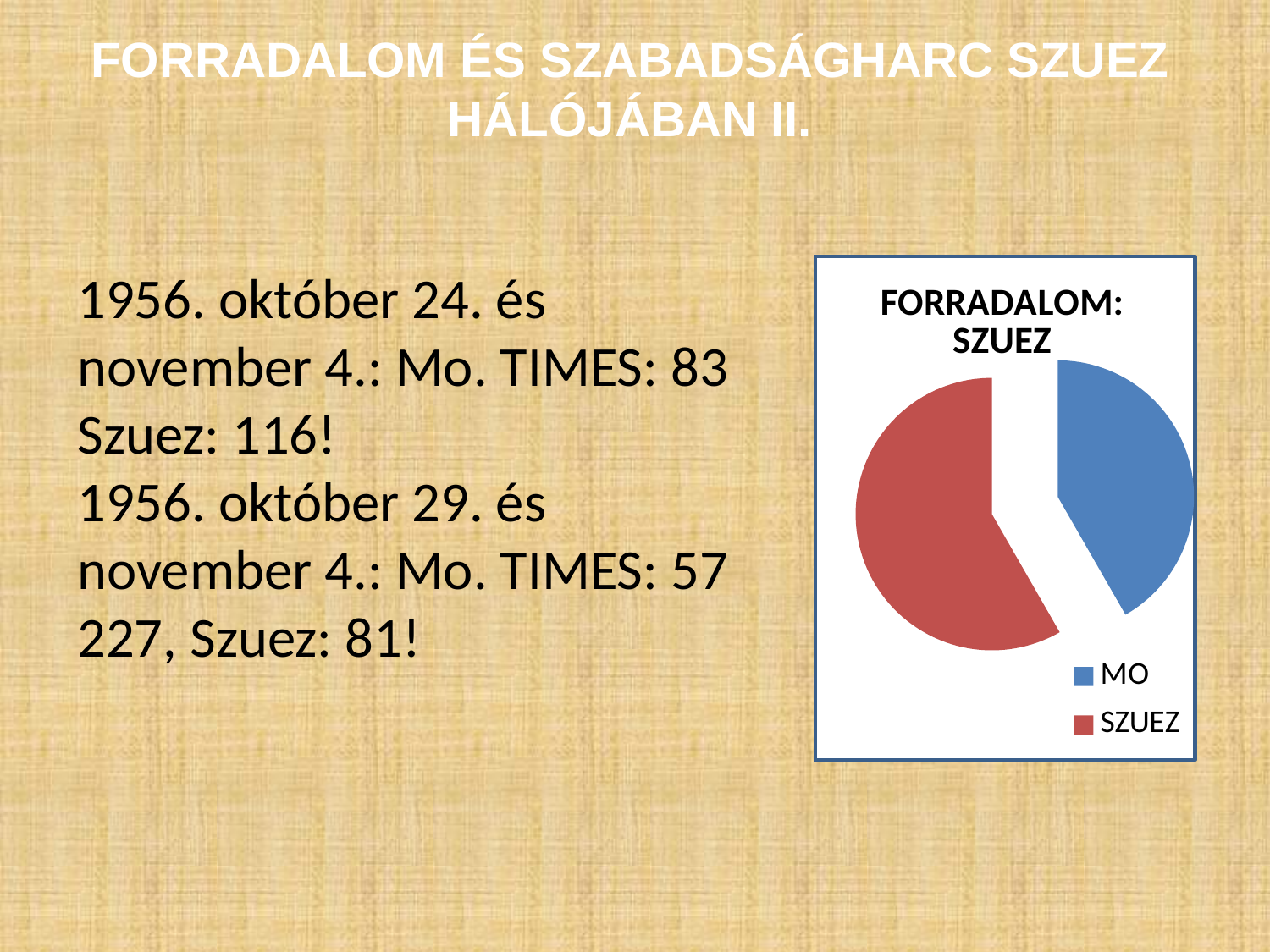
What kind of chart is shown on the slide? pie chart What is the title of the chart? FORRADALOM: SZUEZ How many entries does the chart legend list? 2 How many slices does the pie chart have? 2 What colour is the SZUEZ slice in the pie chart? red Which slice of the pie chart is the largest? SZUEZ Which slice of the pie chart is the smallest? MO Which is larger in the pie chart, MO or SZUEZ? SZUEZ